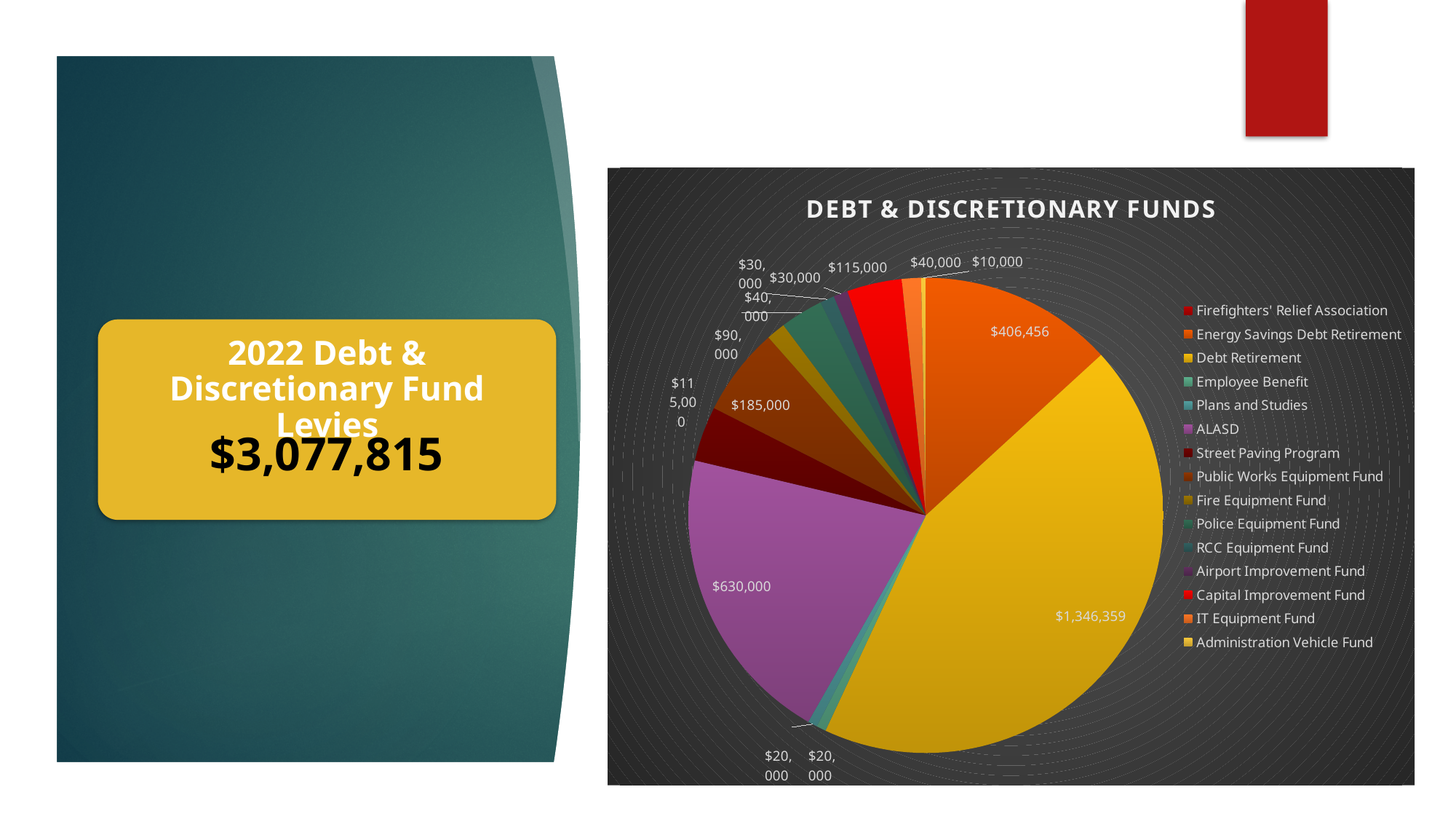
How many entries does the legend list? 15 What kind of chart is shown on the slide? Pie chart What colour is the Debt Retirement slice in the pie chart? Yellow (gold) Which fund has the largest slice in the pie chart? Debt Retirement What is the difference between the Debt Retirement value and the ALASD value? $716,359 What is the value shown for the Public Works Equipment Fund slice? $185,000 What is the value shown for the Debt Retirement slice? $1,346,359 What is the difference between the Energy Savings Debt Retirement value and the Public Works Equipment Fund value? $221,456 Which is larger, the ALASD slice or the Energy Savings Debt Retirement slice? ALASD What is the title of the chart? DEBT & DISCRETIONARY FUNDS What is the value shown for the Energy Savings Debt Retirement slice? $406,456 What is the value shown for the ALASD slice? $630,000